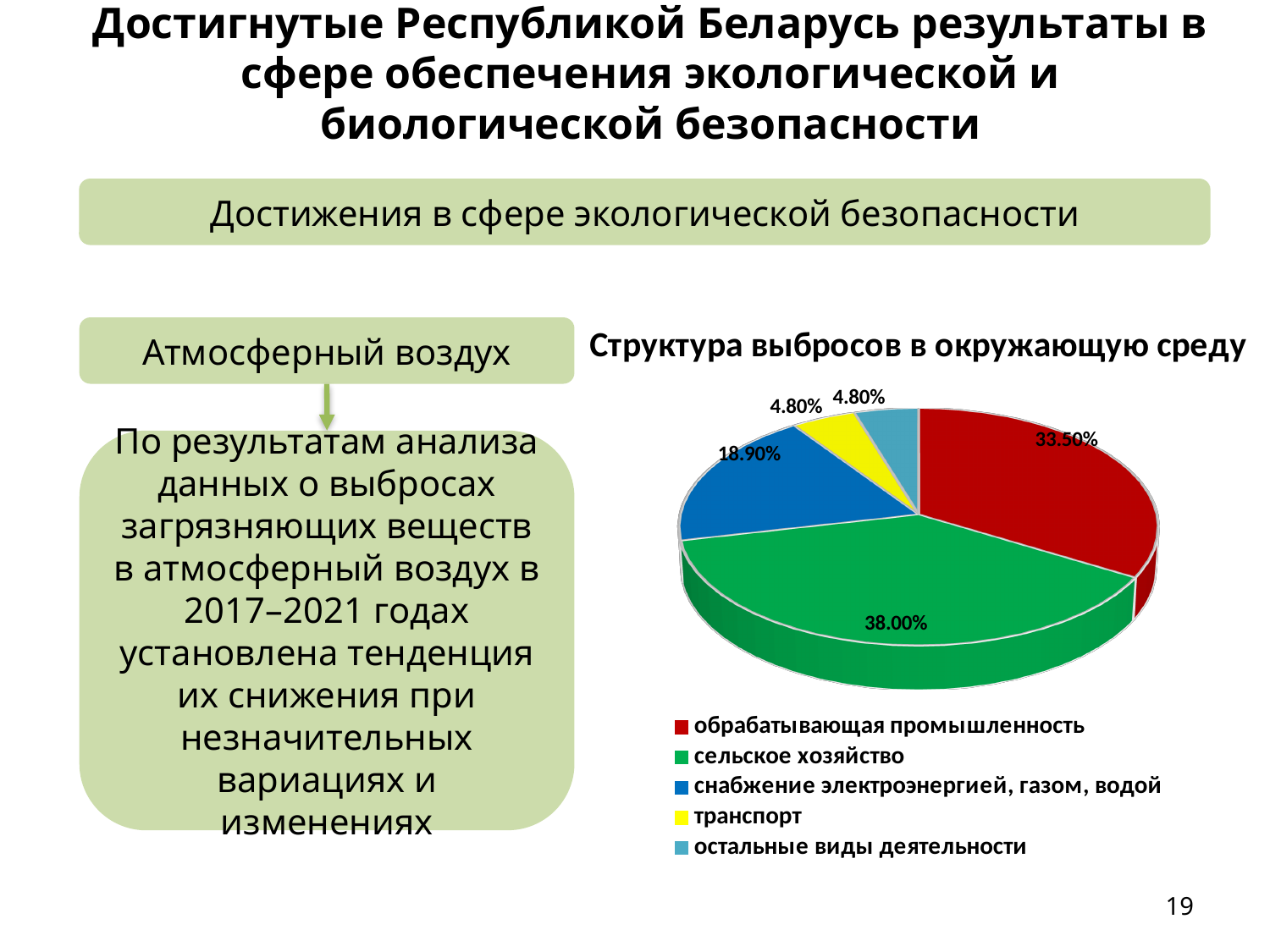
How many categories does the legend of the pie chart list? 5 What share of emissions does транспорт account for? 4.80% What is the smallest percentage shown on the pie chart? 4.80% What share of emissions does сельское хозяйство account for? 38.00% Which category has the largest share of emissions? сельское хозяйство What share of emissions does снабжение электроэнергией, газом, водой account for? 18.90% What type of chart is shown on the slide? Pie chart Which has a larger share: обрабатывающая промышленность or снабжение электроэнергией, газом, водой? обрабатывающая промышленность What is the title of the chart on the slide? Структура выбросов в окружающую среду What colour represents сельское хозяйство in the pie chart? Green What share of emissions does обрабатывающая промышленность account for? 33.50% What is the difference between the shares of сельское хозяйство and обрабатывающая промышленность? 4.50%